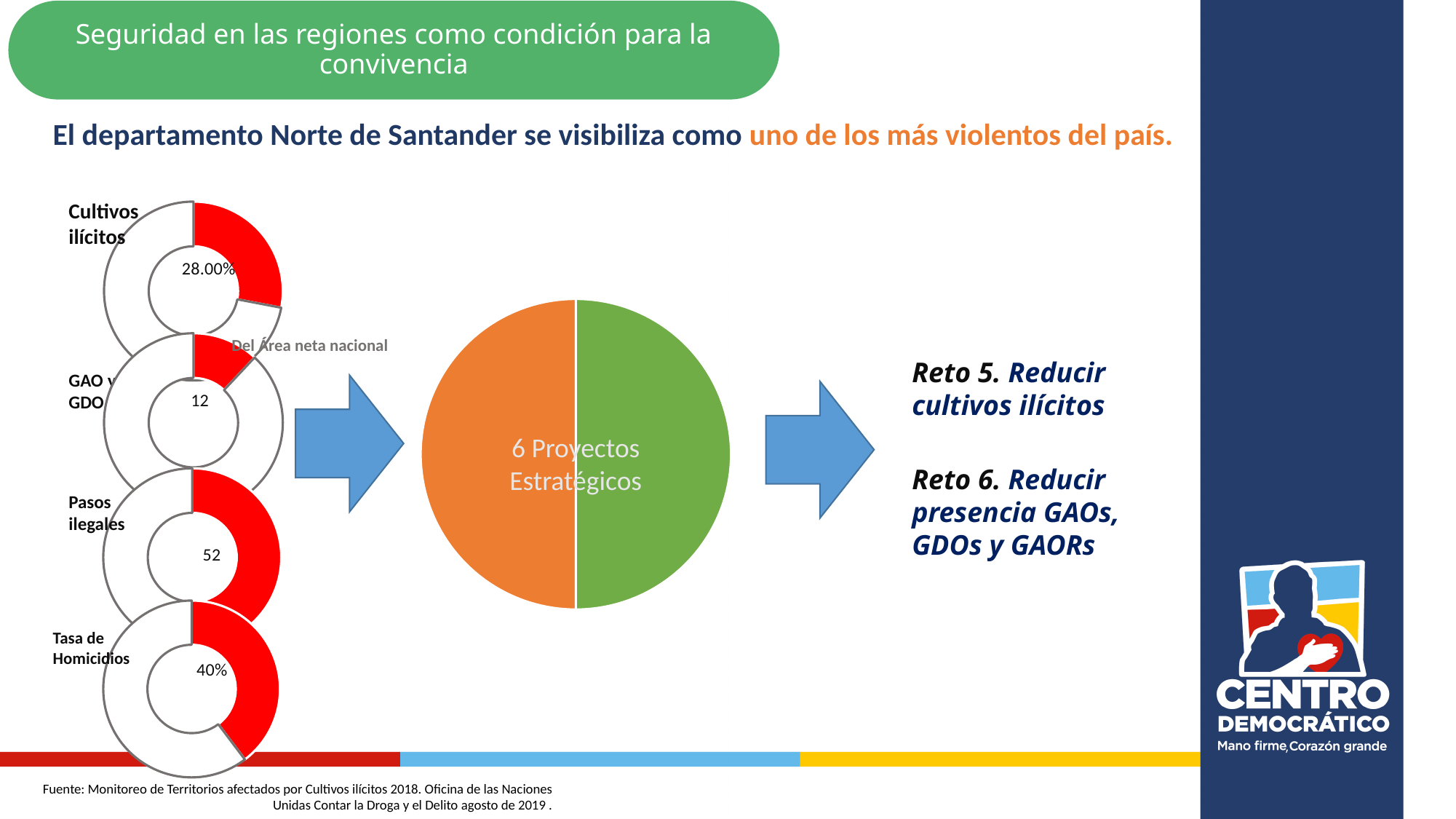
How many doughnut charts are shown on the left side of the slide? 4 In the GAO y GDO doughnut chart, what value is shown in the centre? 12 What two colours are the slices of the 6 Proyectos Estratégicos pie chart? Orange and green What colour is the filled segment in the Tasa de Homicidios doughnut chart? Red In the Cultivos ilícitos doughnut chart, what value is shown in the centre? 28.00% In the Pasos ilegales doughnut chart, what value is shown in the centre? 52 How many slices does the 6 Proyectos Estratégicos pie chart have? 2 What kind of chart is the Cultivos ilícitos chart? Doughnut chart What kind of chart is the 6 Proyectos Estratégicos chart in the middle of the slide? Pie chart In the Tasa de Homicidios doughnut chart, what value is shown in the centre? 40%